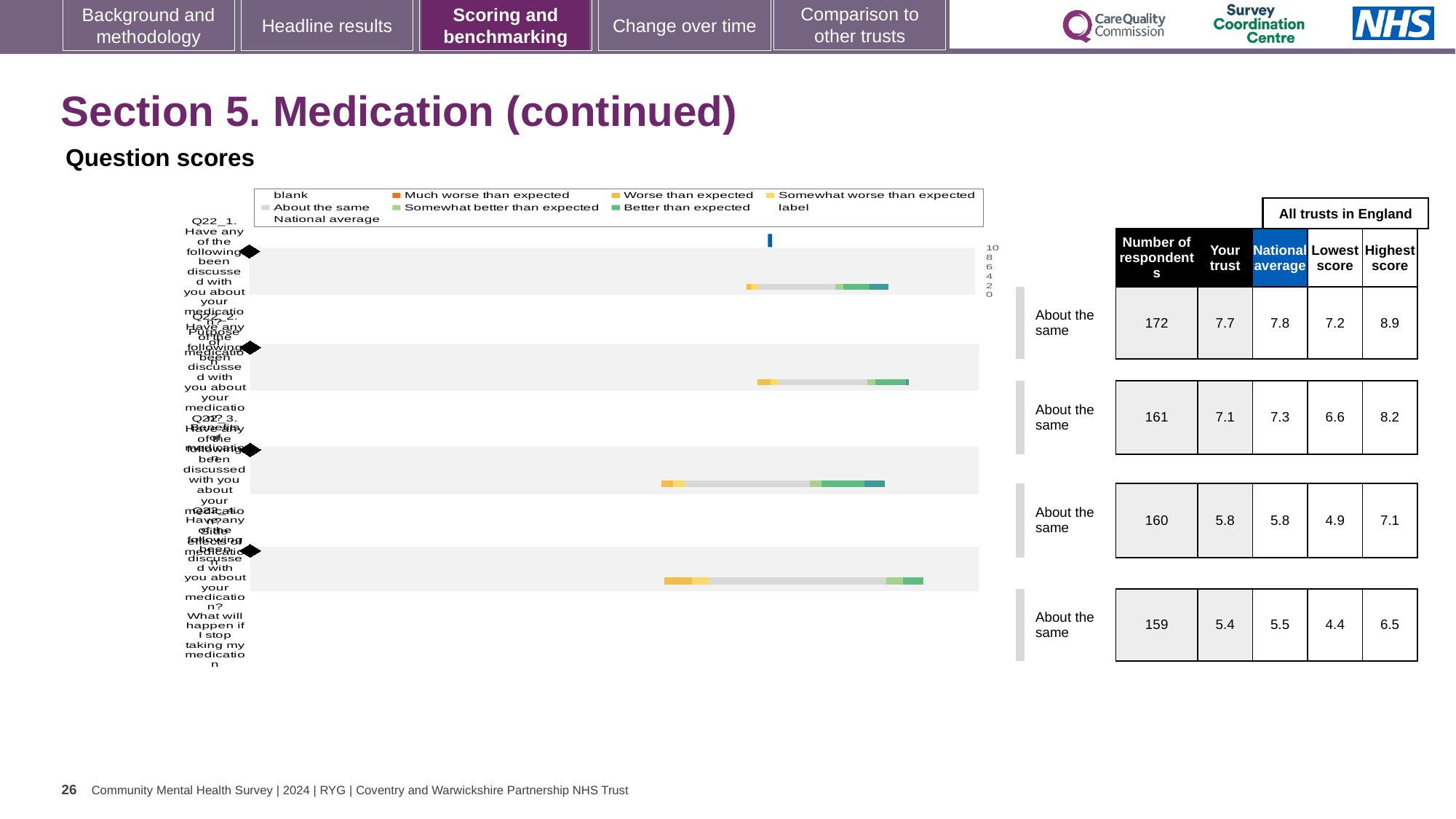
In the first row, which is larger: the 'Your trust' score or the national average? National average What is the highest score for the third row of the table? 7.1 What is the lowest score for the fourth row of the table? 4.4 In the second row, what is the difference between the highest score and the lowest score? 1.6 How many question rows are plotted in the chart? 4 What colour does the legend use for 'Much worse than expected'? orange What benchmark category is shown for all four question rows? About the same What is the national average for the second row of the table? 7.3 Which row has the lowest number of respondents? the fourth row (159) What kind of chart is shown under 'Question scores'? bar chart In the table beside the chart, what is the number of respondents for the first row? 172 What is the 'Your trust' score for the first row of the table? 7.7